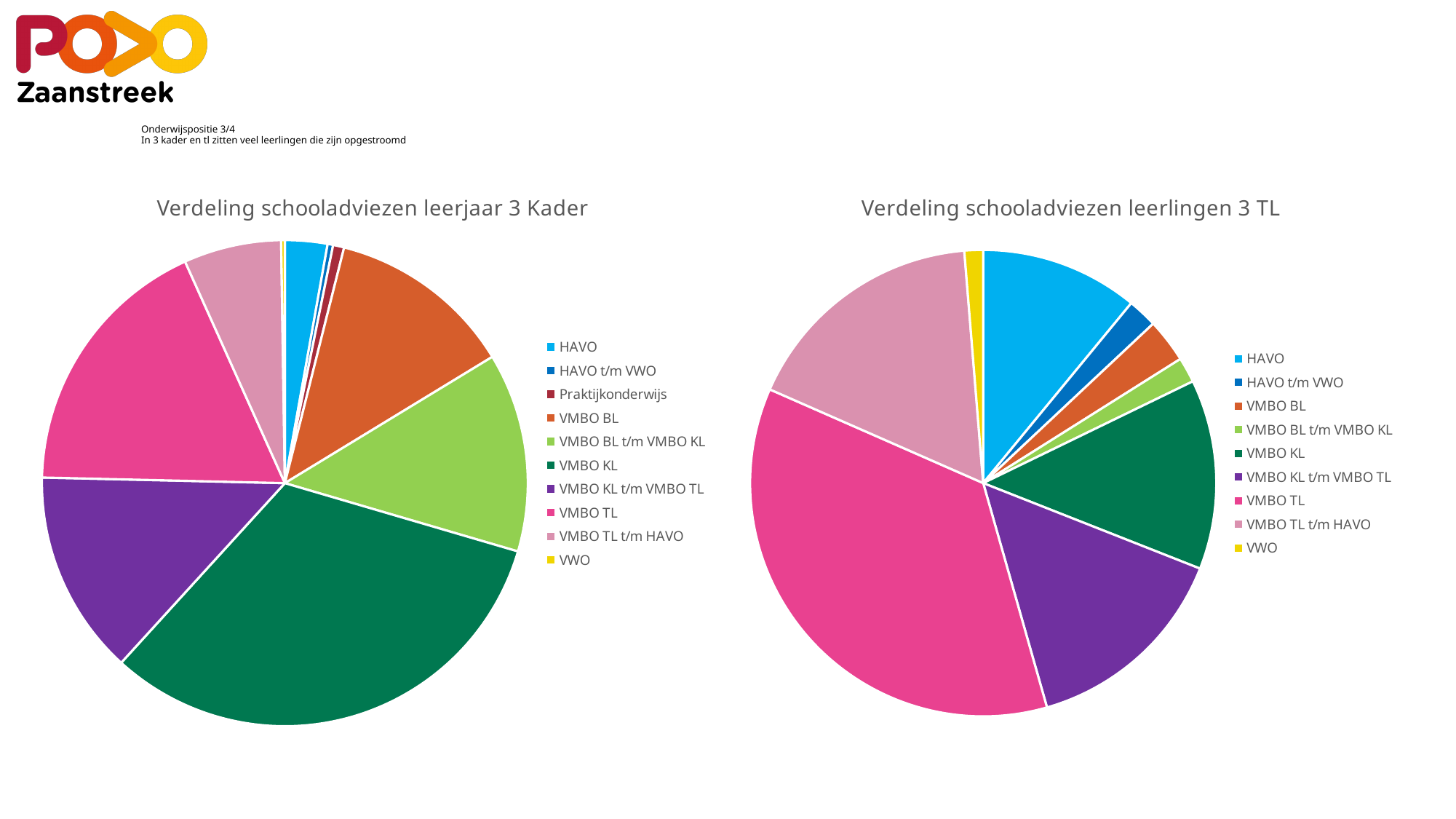
In "Verdeling schooladviezen leerjaar 3 Kader", which slice is larger: VMBO TL or VMBO KL t/m VMBO TL? VMBO TL In "Verdeling schooladviezen leerjaar 3 Kader", which category has the largest slice? VMBO KL What kind of chart is "Verdeling schooladviezen leerlingen 3 TL"? Pie chart Which category appears in the legend of the left pie chart but not in the legend of the right pie chart? Praktijkonderwijs In "Verdeling schooladviezen leerlingen 3 TL", which category has the largest slice? VMBO TL What is the title of the pie chart on the right of the slide? Verdeling schooladviezen leerlingen 3 TL In "Verdeling schooladviezen leerjaar 3 Kader", which slice is larger: HAVO or VMBO TL t/m HAVO? VMBO TL t/m HAVO How many categories does the legend of "Verdeling schooladviezen leerlingen 3 TL" list? 9 In "Verdeling schooladviezen leerlingen 3 TL", which slice is larger: VMBO BL or VMBO KL? VMBO KL What kind of chart is "Verdeling schooladviezen leerjaar 3 Kader"? Pie chart How many categories does the legend of "Verdeling schooladviezen leerjaar 3 Kader" list? 10